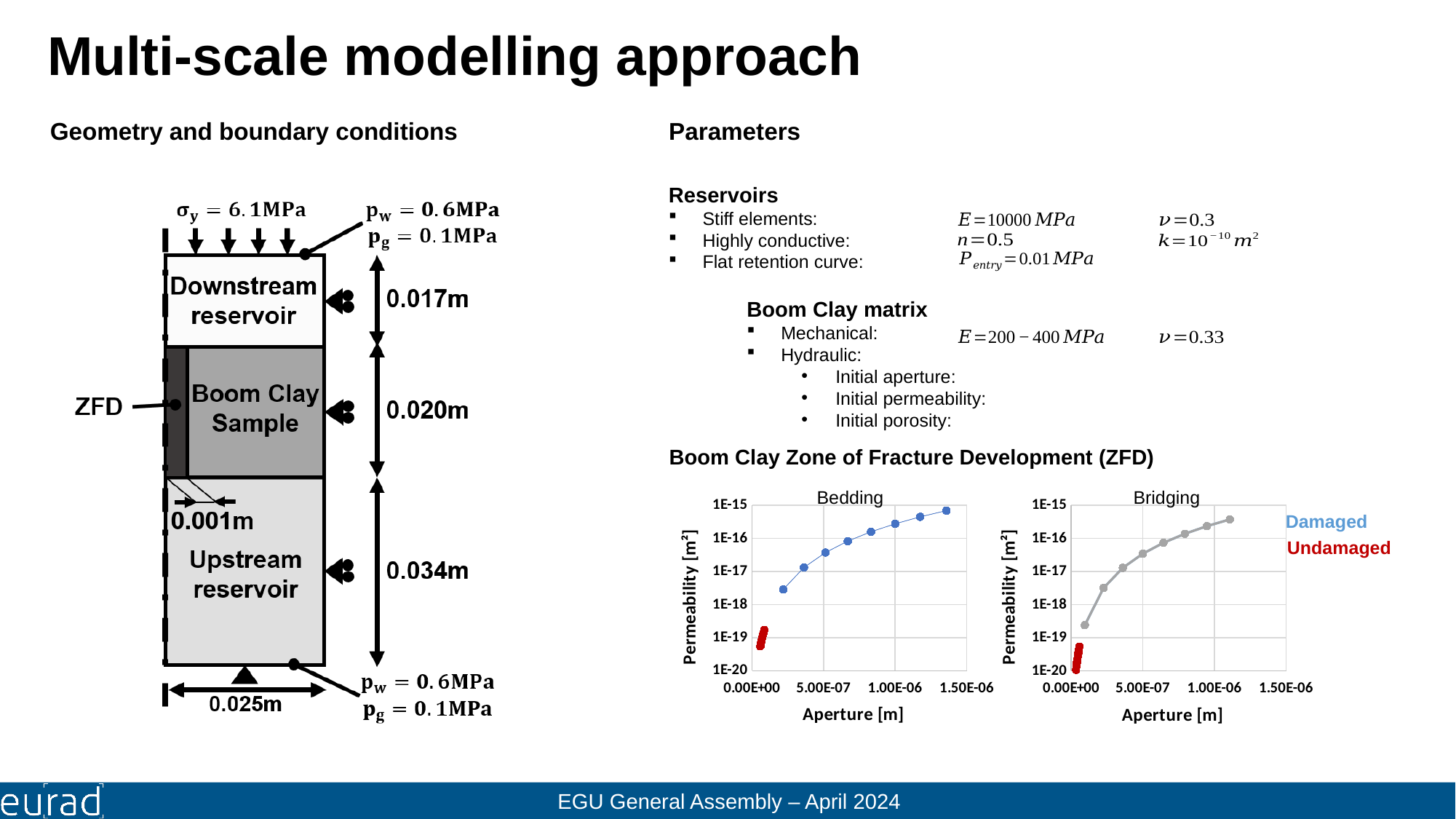
Which series is shown in red in the Bedding and Bridging charts? Undamaged In the Bridging chart, are the undamaged (red) permeability values greater or less than 1E-18? less What is the y-axis label of the Bedding chart? Permeability [m²] In the Bridging chart, is the highest damaged permeability value greater or less than 1E-16? greater What kind of chart is the Bedding chart? scatter chart In the Bedding chart, does the damaged permeability rise or fall as aperture increases? rise In the Bedding chart, is the highest damaged permeability value greater or less than 1E-16? greater In the Bridging chart, does the damaged permeability rise or fall as aperture increases? rise How many series does the legend next to the Bridging chart list? 2